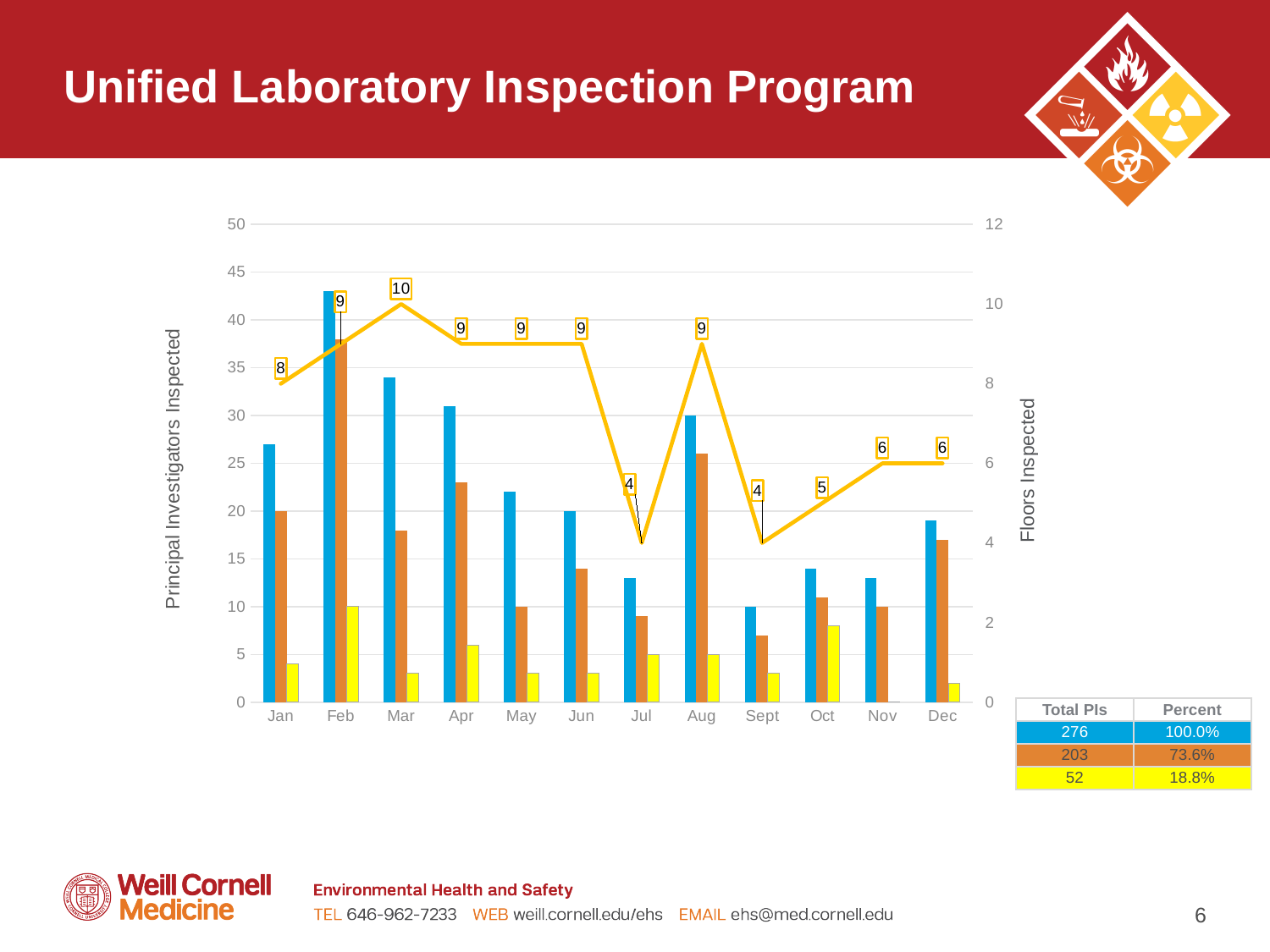
How many months are shown along the x axis of the chart? 12 What is the difference between the Floors Inspected values for March and July? 6 Is the value of the blue bar for Feb greater or less than 40 on the left axis? greater What is the Floors Inspected value for November? 6 What is the title of the right-hand vertical axis? Floors Inspected Does the Floors Inspected line rise or fall from January to March? rises What is the Floors Inspected value for July? 4 Is the value of the blue bar for May greater or less than 20 on the left axis? greater Is the value of the orange bar for Mar greater or less than 20 on the left axis? less Which month has the highest Floors Inspected value on the line? Mar Which month has a higher Floors Inspected value, August or October? Aug How many floors were inspected in March according to the line's data label? 10